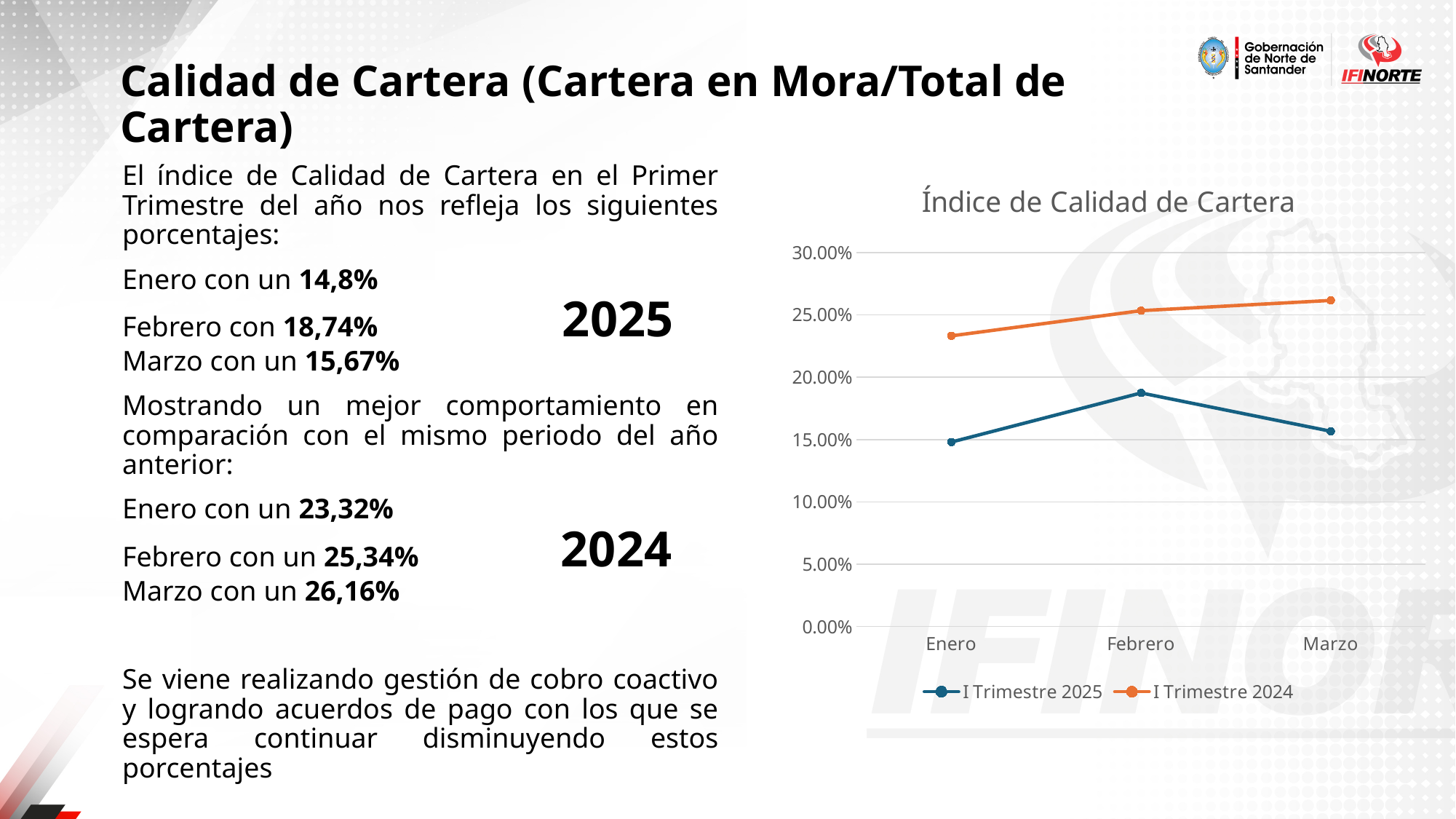
How many series does the chart legend list? 2 Which month has the lowest value in the I Trimestre 2024 series? Enero Is the value for Febrero in the I Trimestre 2025 series greater or less than 15.00%? greater Which month has the highest value in the I Trimestre 2025 series? Febrero Which series is drawn in orange in the chart? I Trimestre 2024 How many months are plotted along the x axis of the chart? 3 What is the title of the chart? Índice de Calidad de Cartera What kind of chart is shown on the slide? line chart Is the value for Enero in the I Trimestre 2025 series greater or less than 20.00%? less Do the values of the I Trimestre 2024 series rise or fall from Enero to Marzo? rise Which series has the larger value for Marzo, I Trimestre 2025 or I Trimestre 2024? I Trimestre 2024 Is the value for Marzo in the I Trimestre 2024 series greater or less than 25.00%? greater